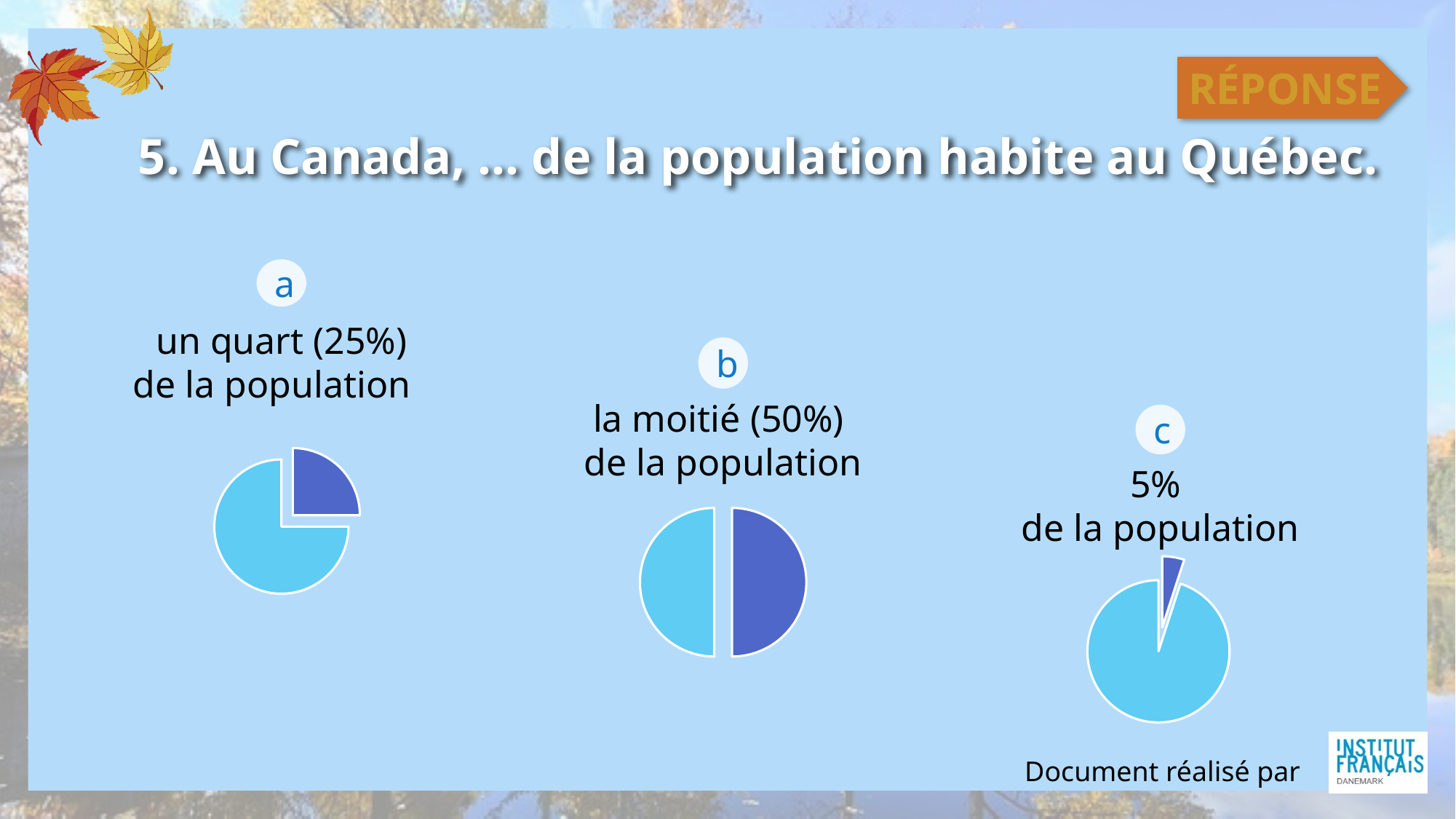
In the pie chart under option a, what share of the population does the dark blue slice represent? 25% Which option's pie chart shows the smallest dark blue share? c Which option's pie chart shows the largest dark blue share? b In the pie chart under option c, what colour is the small 5% slice? dark blue How many pie charts are shown on the slide? 3 What text label accompanies the pie chart under option a? un quart (25%) de la population In the pie chart under option b, what share does the dark blue slice represent? 50% What is the difference between the share shown in the pie chart under option b and the share shown in the pie chart under option a? 25% What kind of chart is shown under option a? pie chart How many slices does the pie chart under option b have? 2 Which pie chart has the larger dark blue slice, the one under option a or the one under option c? a In the pie chart under option c, what share does the dark blue slice represent? 5%